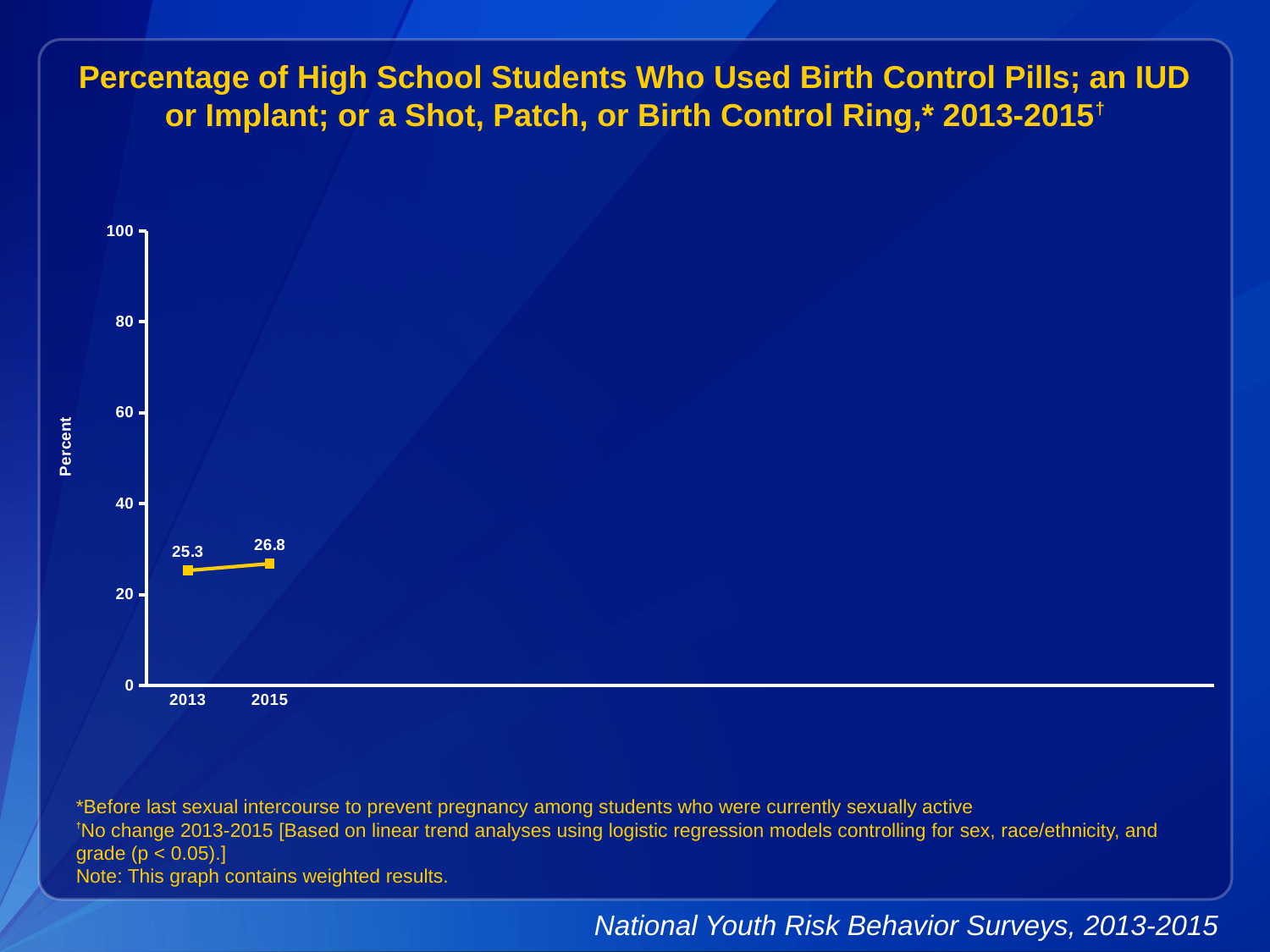
Do the values rise or fall from 2013 to 2015? Rise Is the value for 2015 greater or less than 20? greater What is the value for 2013? 25.3 Is the value for 2015 larger than the value for 2013? Yes What kind of chart is shown on the slide? Line chart What is the difference between the 2015 value and the 2013 value? 1.5 Which year has the lower value? 2013 What is the value for 2015? 26.8 How many data points are plotted on the chart? 2 Which year has the higher value? 2015 Is the value for 2013 greater or less than 40? less What is the label on the vertical axis? Percent